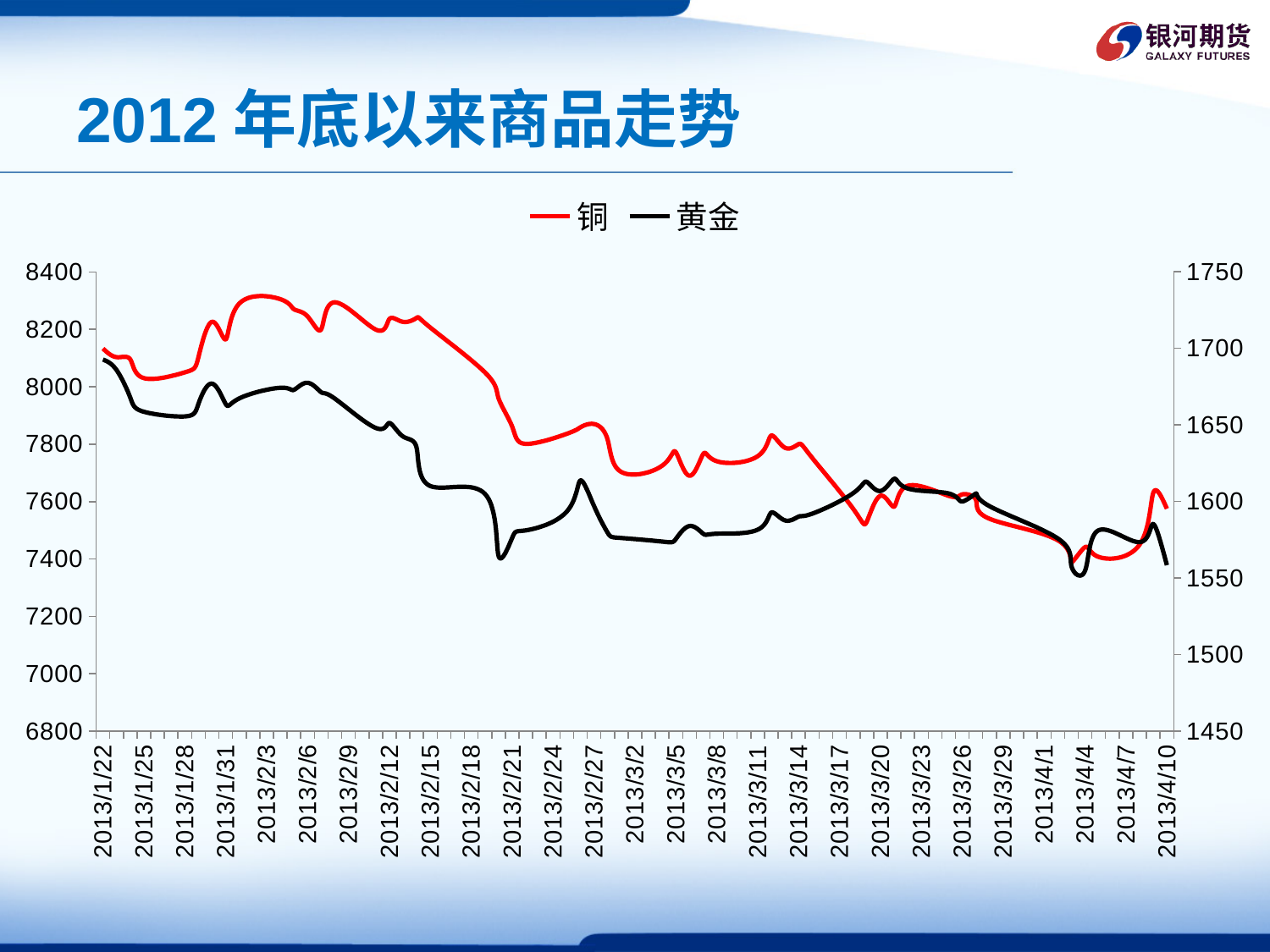
How many date labels are shown on the x axis? 27 Overall, does the 黄金 series rise or fall from 2013/1/22 to 2013/4/10? fall How many series does the legend list? 2 Is the value for 铜 at 2013/4/10 greater or less than 7800? less Overall, does the 铜 series rise or fall from 2013/1/22 to 2013/4/10? fall Is the value for 黄金 at 2013/1/22 (right axis) greater or less than 1650? greater What is the title of the chart on the slide? 2012 年底以来商品走势 What kind of chart is shown on the slide? line chart Is the value for 铜 at 2013/3/2 greater or less than 7800? less Which colour is used for the 黄金 series? black